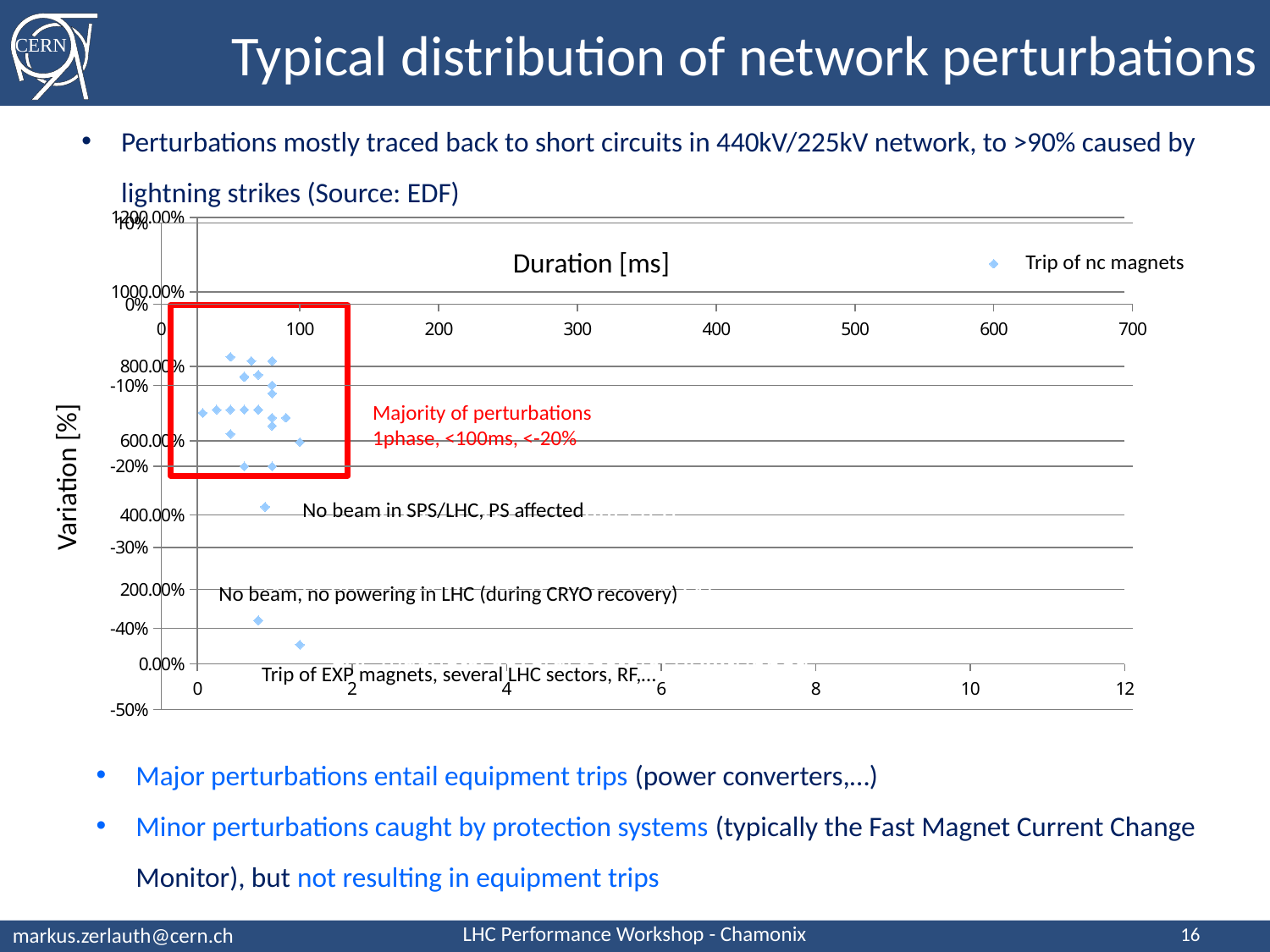
Is the variation of the lowest plotted point greater or less than -40%? less Is the duration of the plotted point with the longest duration greater or less than 200 ms? greater What kind of chart is shown on the slide? scatter chart Is the variation of the highest plotted point greater or less than -20%? greater What is the title of the horizontal axis of the chart? Duration [ms]